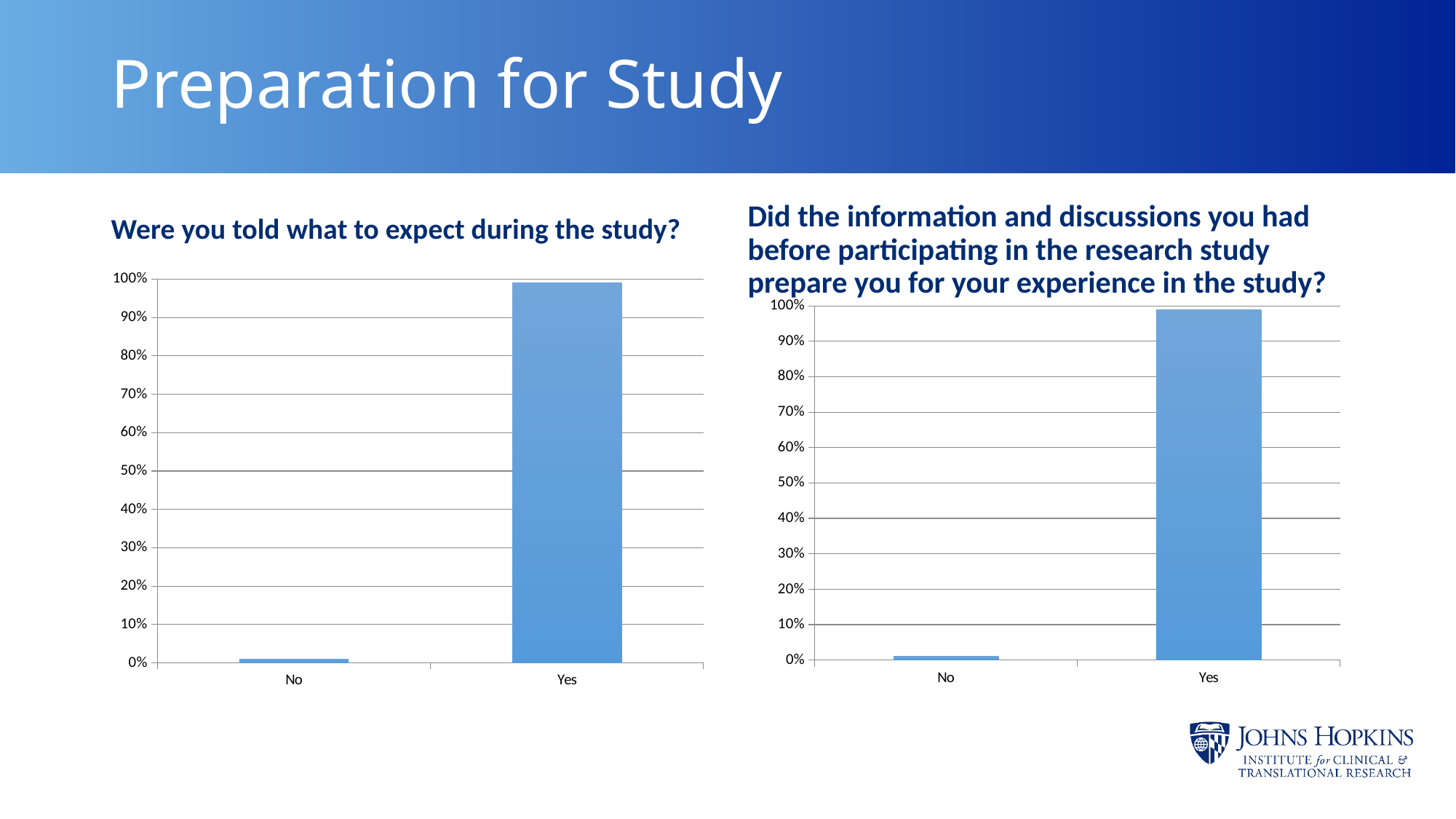
In the right chart, which is larger, the value for No or the value for Yes? Yes In the right chart, is the value for Yes greater or less than 80%? greater What kind of chart is the left chart? bar chart In the right chart, is the value for No greater or less than 10%? less In the right chart ("Did the information and discussions you had before participating in the research study prepare you for your experience in the study?"), which category has the highest value? Yes What is the title of the left chart? Were you told what to expect during the study? In the right chart, which category has the lowest value? No In the left chart, is the value for No greater or less than 10%? less How many categories are shown on the x axis of the left chart? 2 In the chart titled "Were you told what to expect during the study?", which category has the highest value? Yes In the chart titled "Were you told what to expect during the study?", which category has the lowest value? No